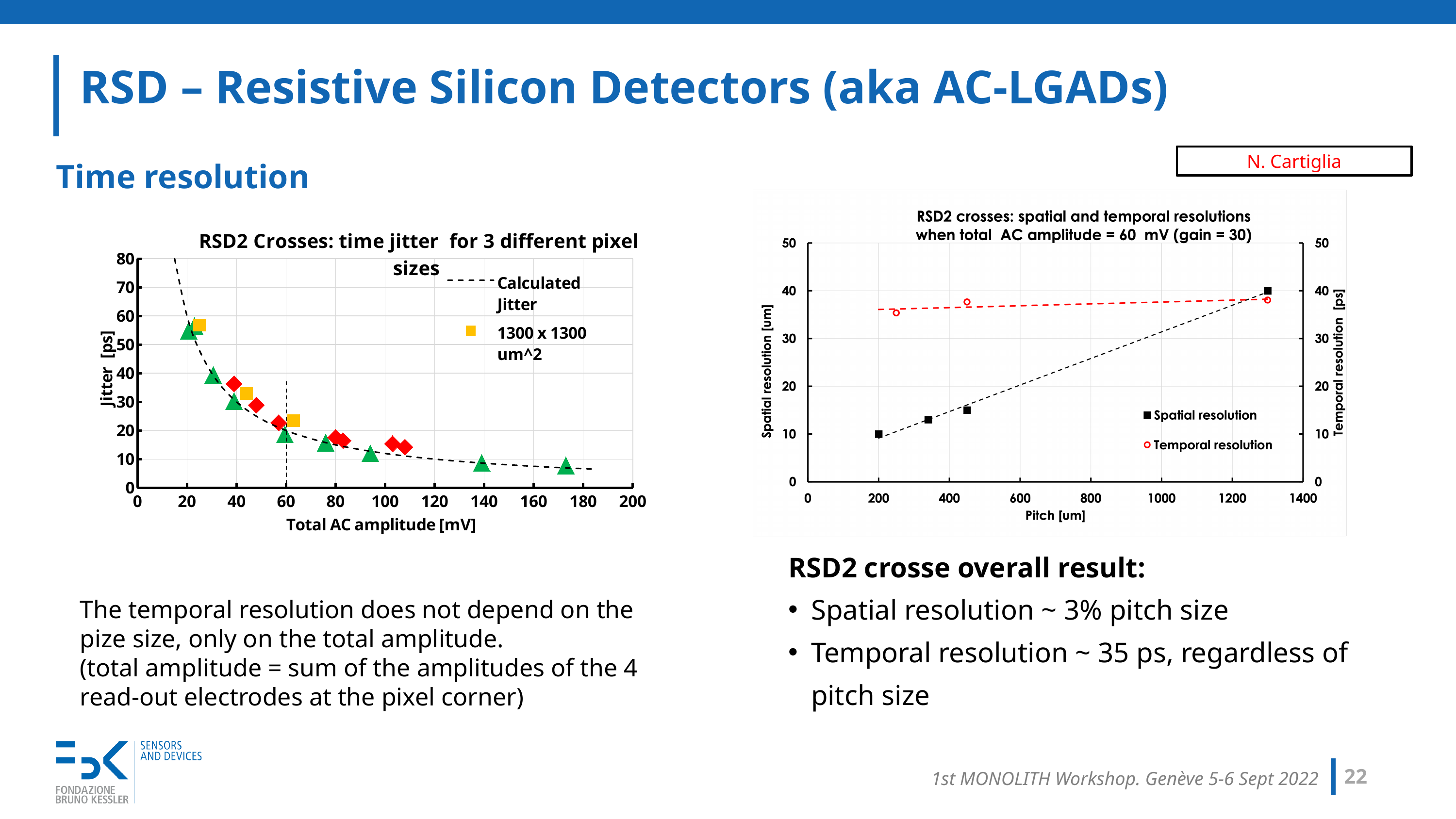
In the right chart (spatial and temporal resolutions), how many spatial resolution data points are plotted? 4 In the right chart (spatial and temporal resolutions), is the spatial resolution at a pitch of about 200 um greater or less than 20 um? less What is the x-axis label of the left chart (time jitter)? Total AC amplitude [mV] In the right chart (spatial and temporal resolutions), is the spatial resolution at a pitch of about 1300 um greater or less than 30 um? greater In the left chart (time jitter), is the jitter at a total AC amplitude of about 170 mV greater or less than 20 ps? less In the right chart (spatial and temporal resolutions), does the spatial resolution rise or fall as the pitch increases? Rise In the right chart (spatial and temporal resolutions), how many series does the legend list? 2 In the left chart (time jitter), which pixel size is named in the legend next to the yellow square marker? 1300 x 1300 um^2 What kind of chart is the left chart titled 'RSD2 Crosses: time jitter for 3 different pixel sizes'? Scatter chart In the right chart (spatial and temporal resolutions), which is larger: the spatial resolution at a pitch of about 1300 um or at a pitch of about 200 um? At about 1300 um In the left chart (time jitter), does the jitter rise or fall as the total AC amplitude increases? Fall